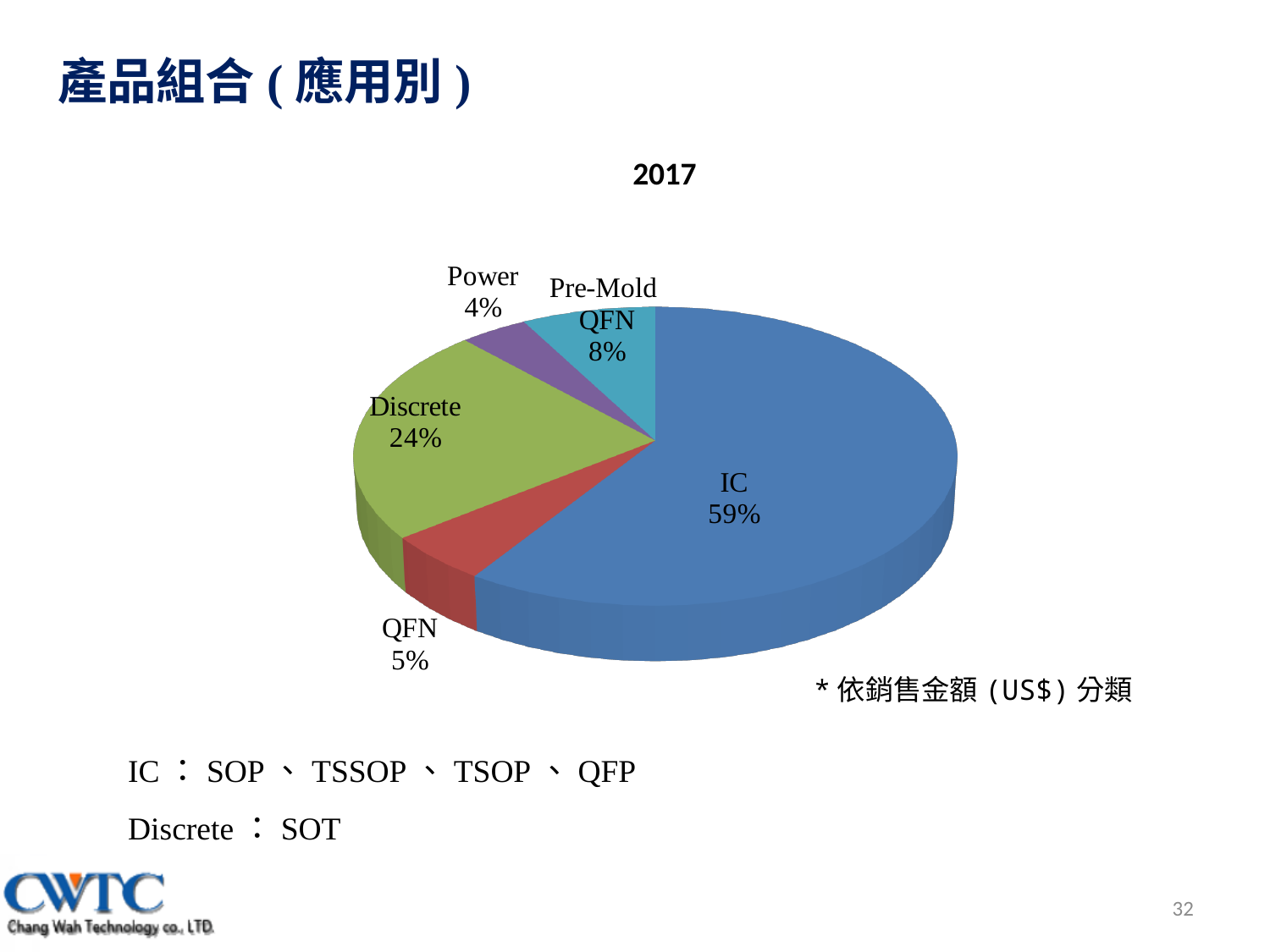
Which category has the largest slice of the pie? IC What is the chart's title? 2017 Which category has the smallest slice of the pie? Power What share of the pie does Pre-Mold QFN account for? 8% How many slices does the pie chart have? 5 What share of the pie does Power account for? 4% What kind of chart is shown on the slide? pie chart Which is larger, the Pre-Mold QFN slice or the QFN slice? Pre-Mold QFN What is the difference in percentage points between the IC and Discrete slices? 35 What share of the pie does QFN account for? 5%